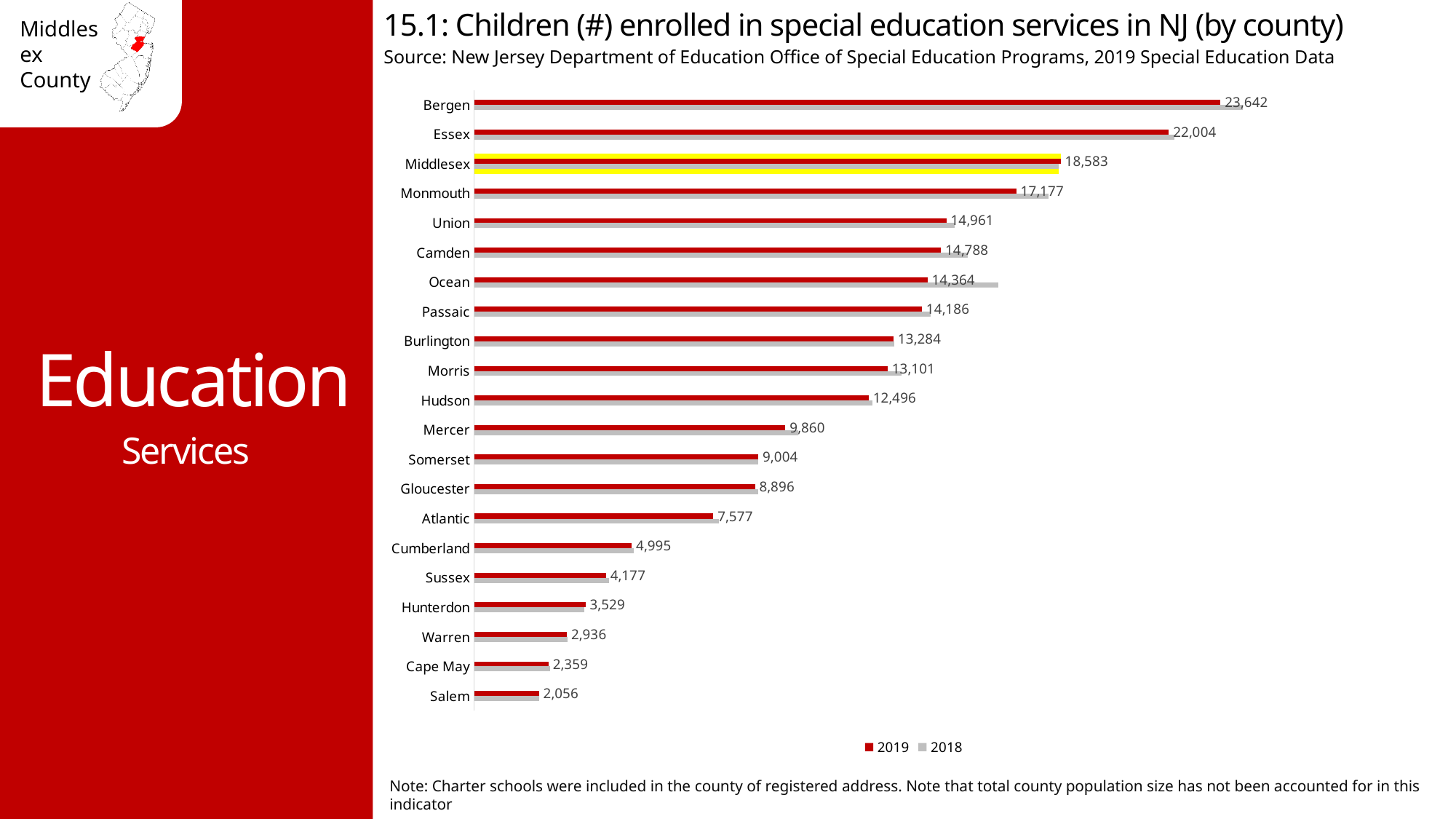
Which county has the highest 2019 value? Bergen How many counties are shown on the chart? 21 Which county has the lowest 2019 value? Salem Which county has the larger 2019 value, Mercer or Somerset? Mercer How many series does the legend list? 2 What is the 2019 value shown for Salem? 2,056 How many children were enrolled in special education services in Middlesex in 2019? 18,583 Which county's bars are highlighted in yellow? Middlesex What is the 2019 value for Bergen? 23,642 What kind of chart is shown on the slide? Bar chart What is the difference between the 2019 values for Bergen and Essex? 1,638 What is the difference between the 2019 values for Middlesex and Monmouth? 1,406